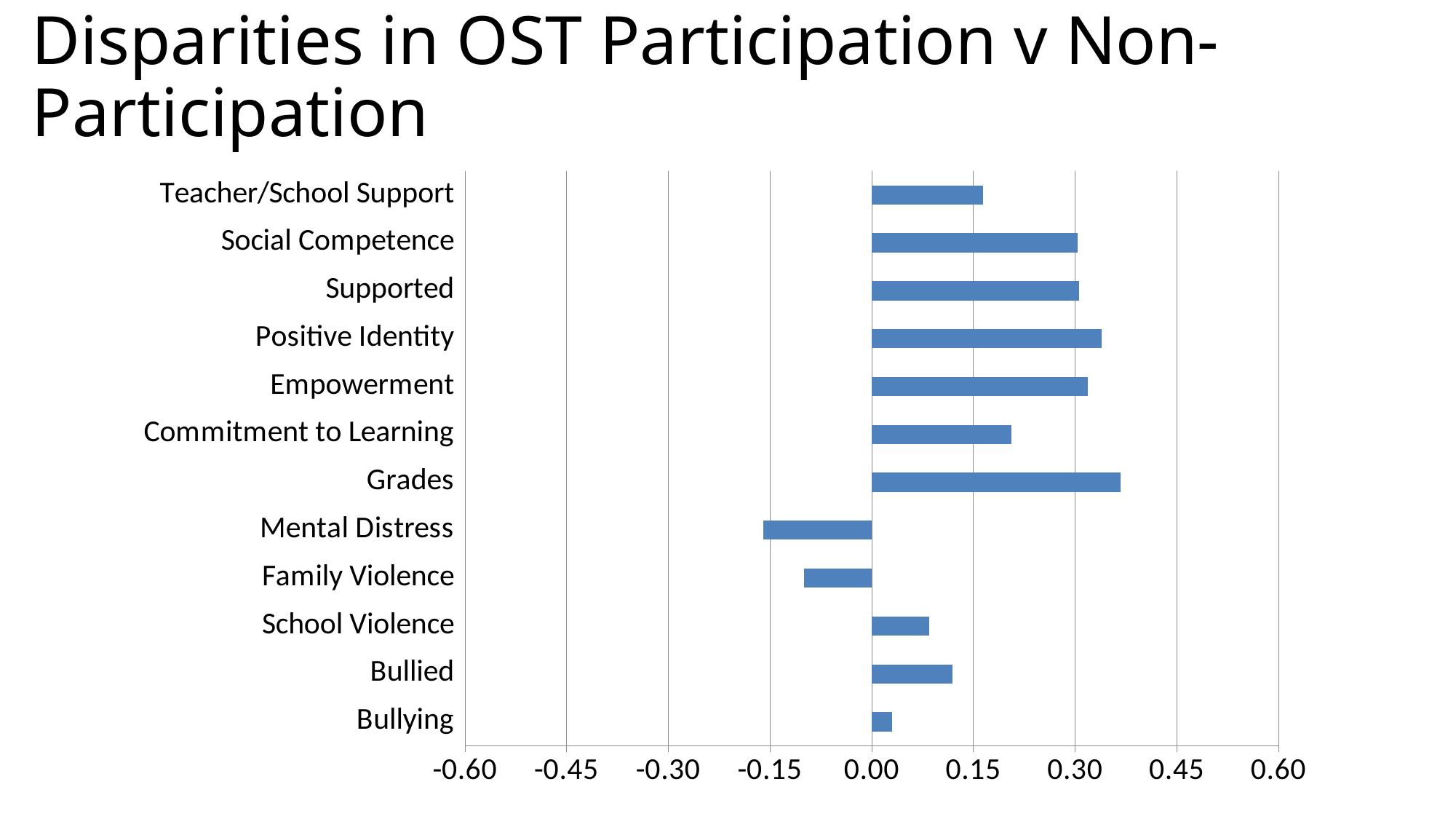
Which category has the highest value in the chart? Grades Is the value for Grades greater or less than 0.30? greater Is the value for Positive Identity greater or less than 0.30? greater Is the value for Teacher/School Support greater or less than 0.30? less How many categories in the chart have a negative value? 2 How many categories are plotted in the chart? 12 Which has the larger value, Grades or Commitment to Learning? Grades Which has the larger value, Bullied or Bullying? Bullied What kind of chart is shown on the slide? bar chart Which category has the lowest value in the chart? Mental Distress